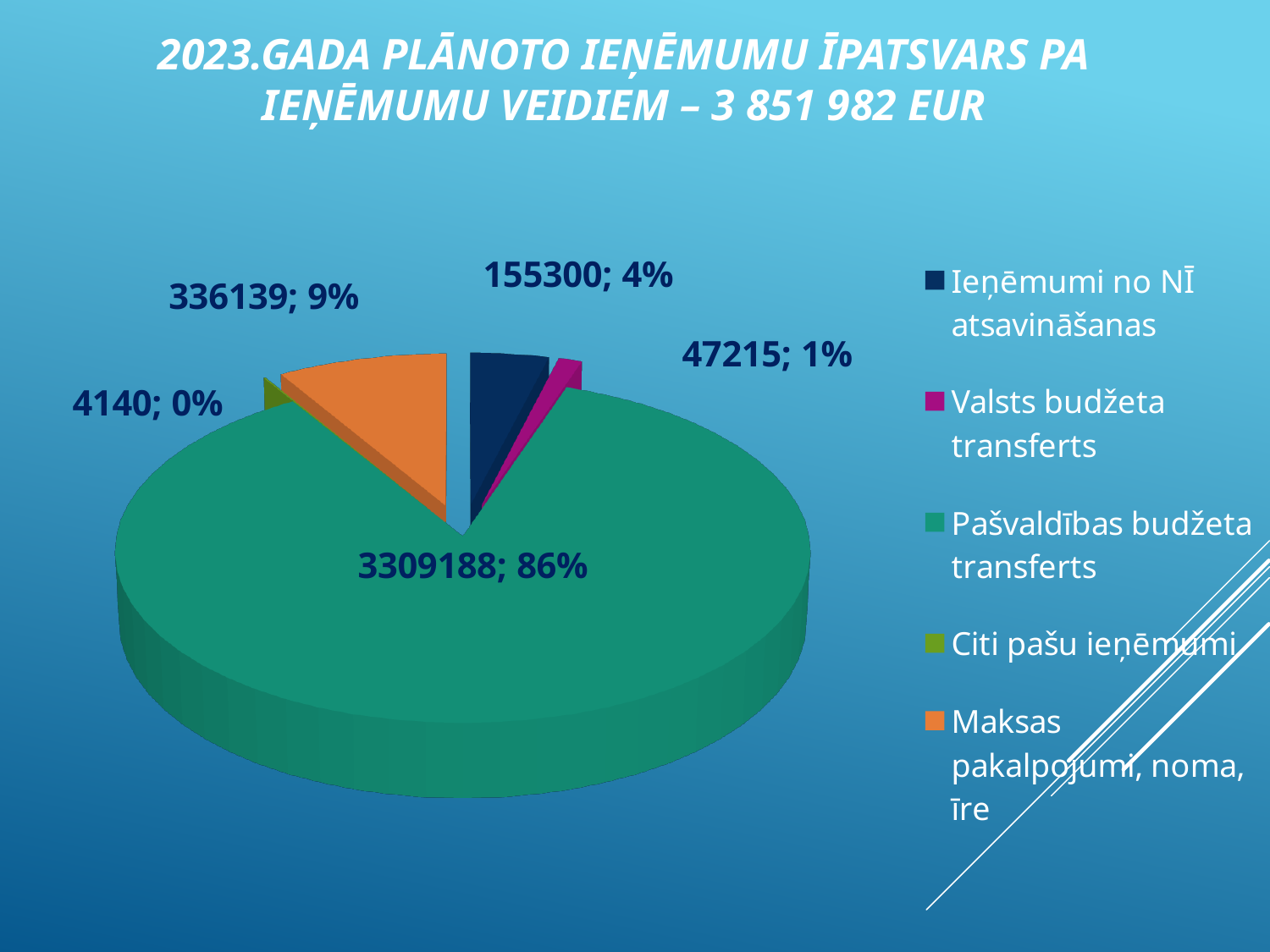
What value is shown for Pašvaldības budžeta transferts? 3309188 Which category has the smallest slice of the pie? Citi pašu ieņēmumi Which is larger, the value for Valsts budžeta transferts or the value for Citi pašu ieņēmumi? Valsts budžeta transferts What value is shown for Valsts budžeta transferts? 47215 What kind of chart is shown on the slide? pie chart How many slices does the pie chart have? 5 What share of the pie does Pašvaldības budžeta transferts represent? 86% What share of the pie does Ieņēmumi no NĪ atsavināšanas represent? 4% What is the difference between the values for Maksas pakalpojumi, noma, īre and Ieņēmumi no NĪ atsavināšanas? 180839 Which category has the largest slice of the pie? Pašvaldības budžeta transferts What value is shown for Maksas pakalpojumi, noma, īre? 336139 How many entries does the legend list? 5